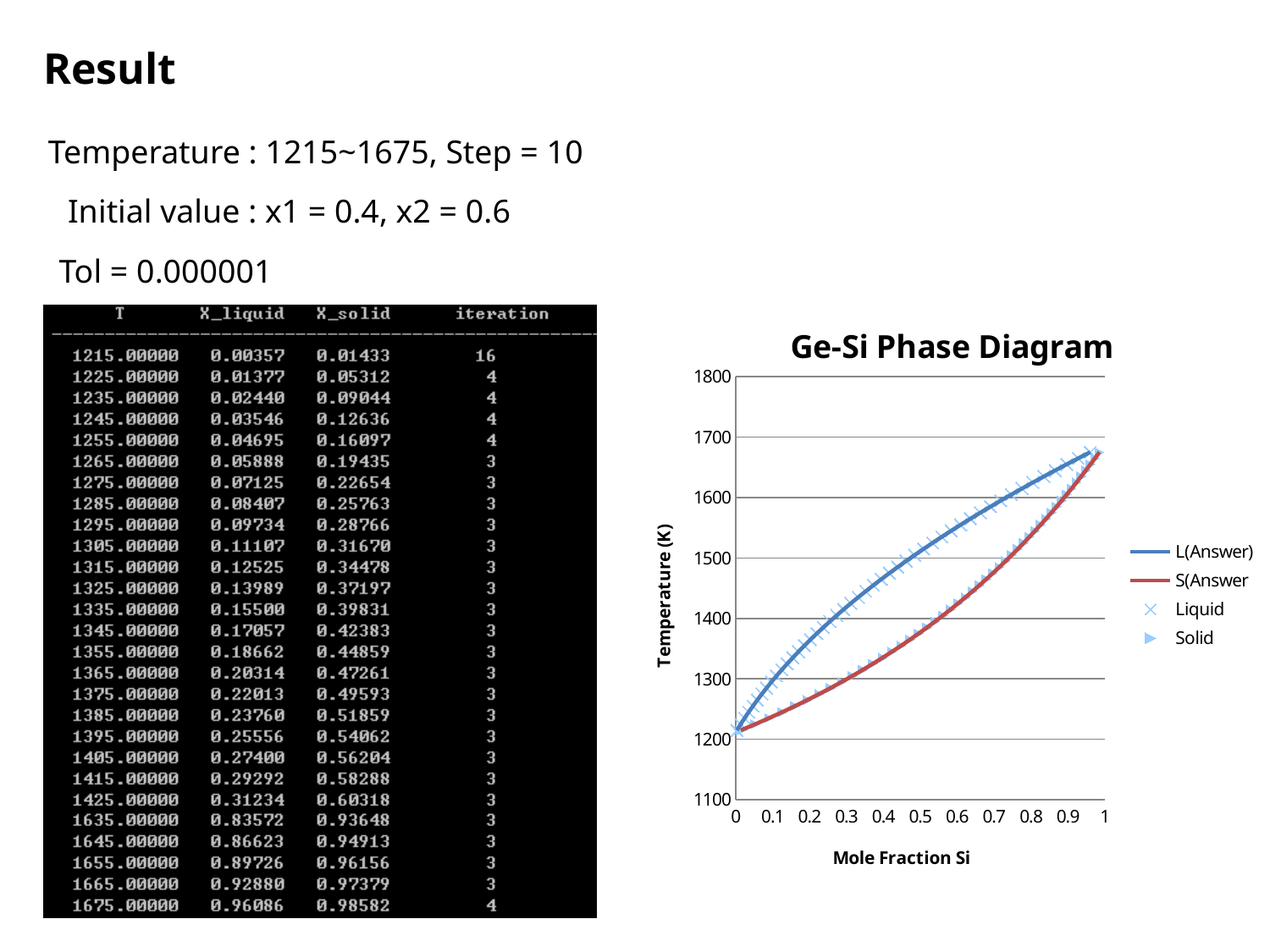
In the Ge-Si Phase Diagram, is the L(Answer) value at Mole Fraction Si = 0.2 greater or less than 1300? greater In the Ge-Si Phase Diagram, does the S(Answer curve rise or fall as Mole Fraction Si increases? rise How many series does the legend of the Ge-Si Phase Diagram list? 4 In the Ge-Si Phase Diagram, is the L(Answer) value at Mole Fraction Si = 0.5 greater or less than 1400? greater What is the title of the chart on the slide? Ge-Si Phase Diagram In the Ge-Si Phase Diagram, at Mole Fraction Si = 0.5, which curve is higher, L(Answer) or S(Answer? L(Answer) In the Ge-Si Phase Diagram, is the S(Answer value at Mole Fraction Si = 0.8 greater or less than 1600? less What kind of chart is the Ge-Si Phase Diagram? line chart In the Ge-Si Phase Diagram, does the L(Answer) curve rise or fall as Mole Fraction Si increases from 0 to 1? rise What is the label of the y axis in the Ge-Si Phase Diagram? Temperature (K)